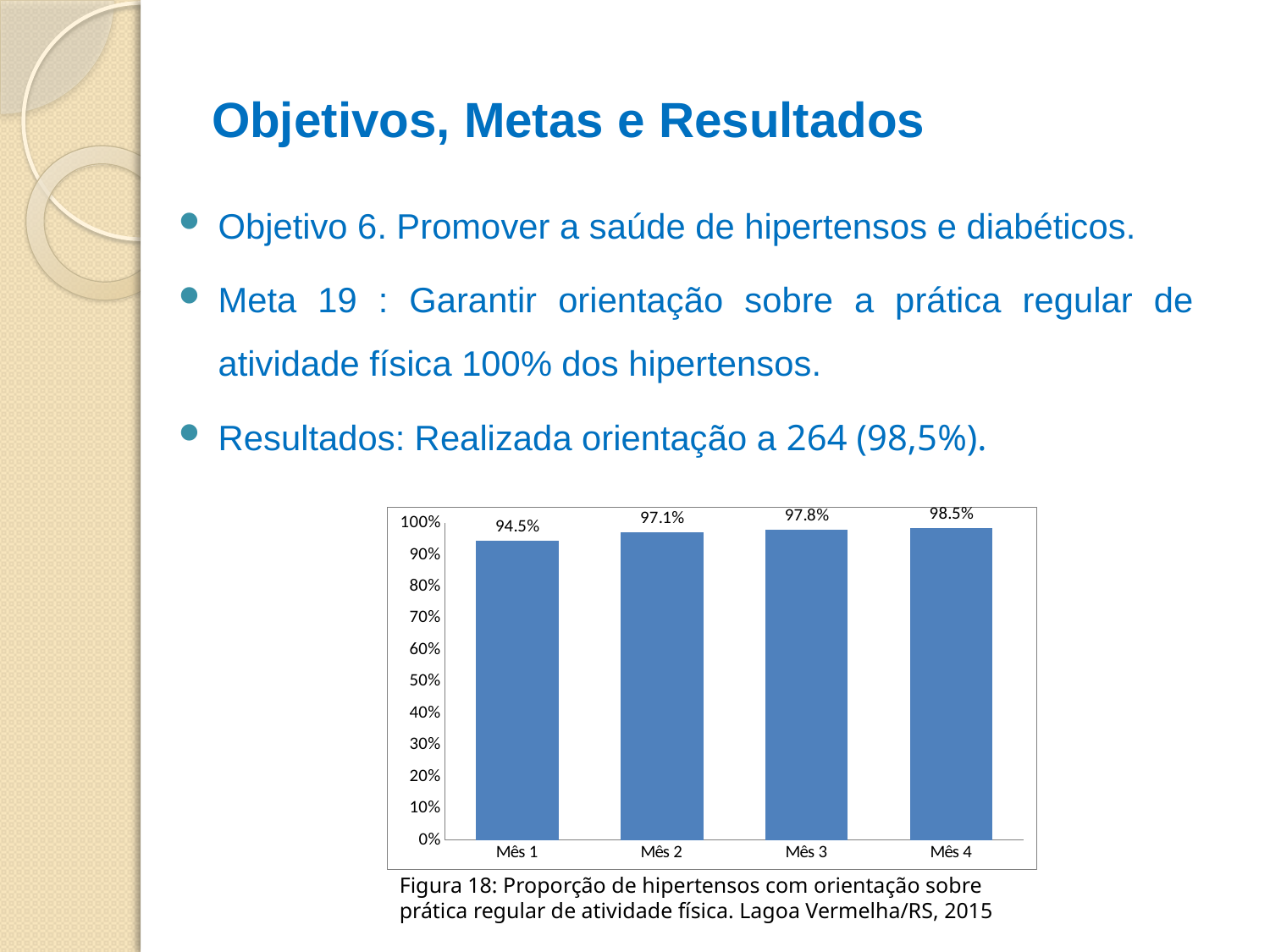
Which month has the highest value? Mês 4 What is the value for Mês 4? 98.5% Which is larger, the value for Mês 1 or the value for Mês 2? Mês 2 What is the value for Mês 2? 97.1% Which month has the lowest value? Mês 1 How many months are shown on the x axis? 4 Is the value for Mês 1 greater or less than 90%? greater Do the values rise or fall from Mês 1 to Mês 4? rise What is the difference between the values for Mês 4 and Mês 1? 4.0% What is the value for Mês 1? 94.5% What kind of chart is shown on the slide? bar chart What is the value for Mês 3? 97.8%